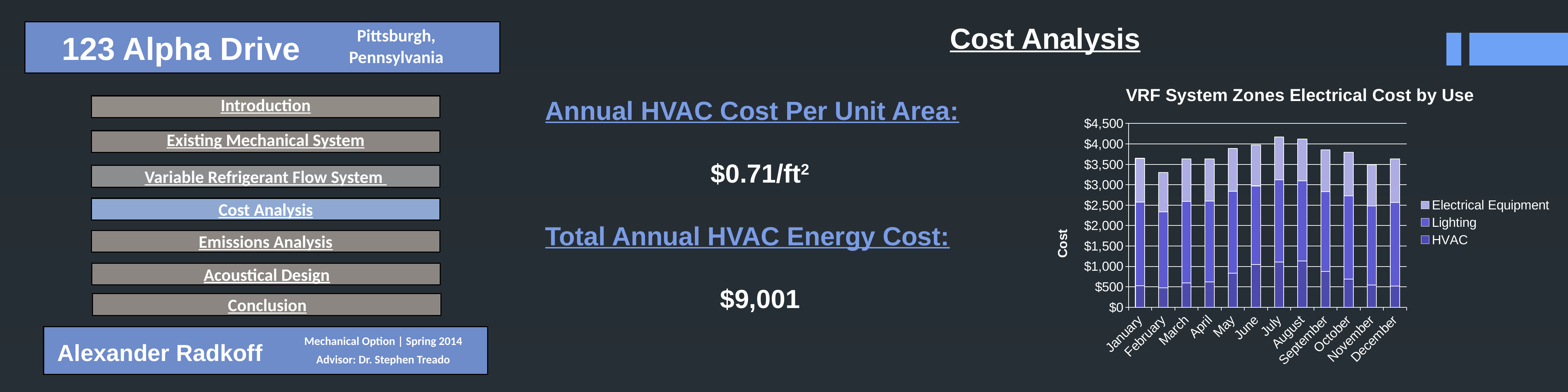
What is the title of the chart on the slide? VRF System Zones Electrical Cost by Use Do the total electrical costs rise or fall from August to November? fall How many months are plotted along the x axis of the chart? 12 Is the total electrical cost for February greater or less than $3,500? less What kind of chart is shown on the slide? Stacked bar chart Which series are listed in the chart's legend? Electrical Equipment, Lighting, HVAC Do the total electrical costs rise or fall from February to July? rise Which month has the larger total electrical cost, February or May? May Is the total electrical cost for July greater or less than $4,000? greater Is the total electrical cost for May greater or less than $3,500? greater How many series does the chart's legend list? 3 Which month has the lowest total electrical cost in the chart? February